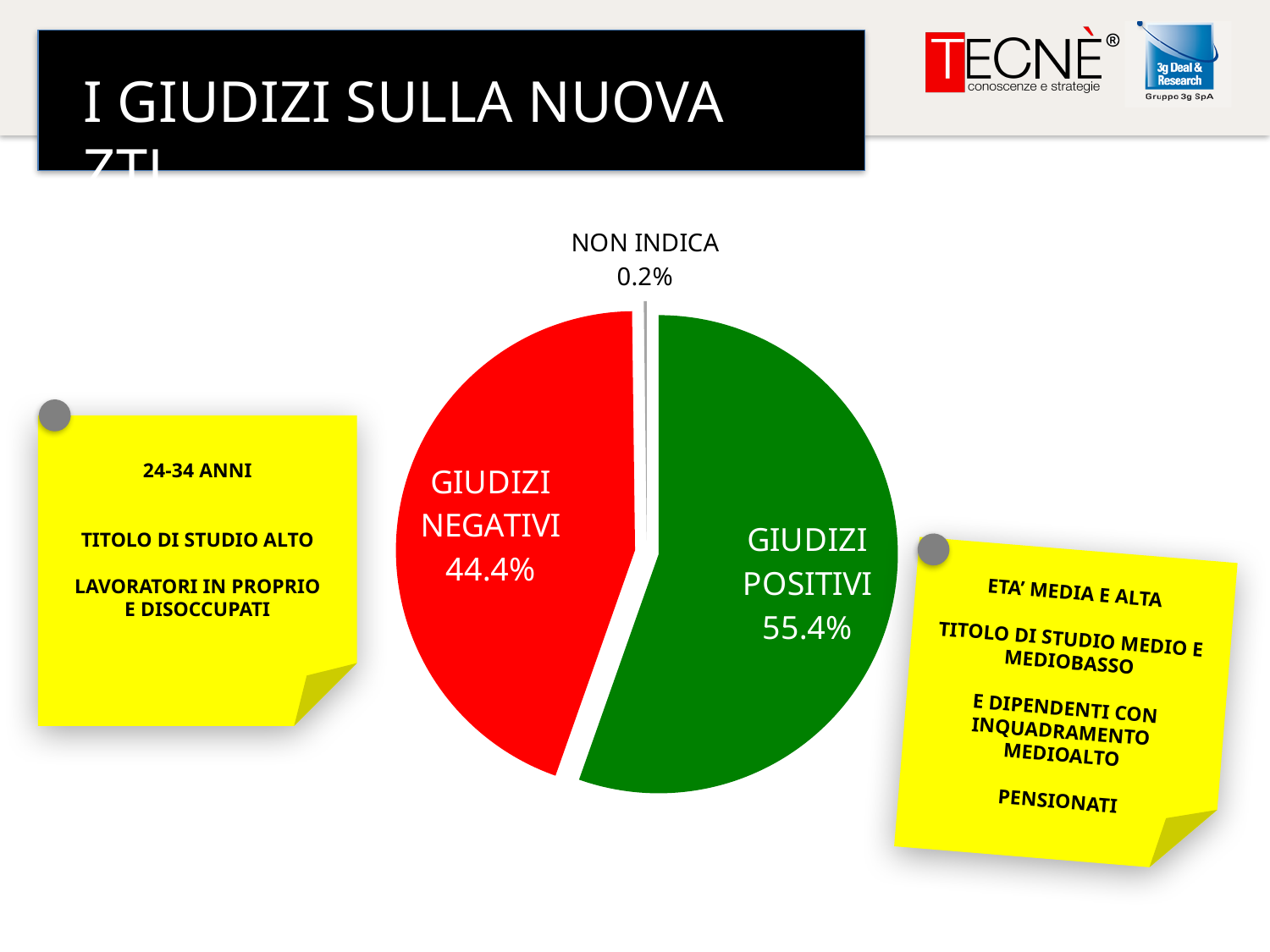
What colour is the GIUDIZI NEGATIVI slice? red What share of the pie is NON INDICA? 0.2% Which slice of the pie is the smallest? NON INDICA Which slice of the pie is the largest? GIUDIZI POSITIVI How many slices does the pie chart have? 3 What is the difference in percentage points between GIUDIZI POSITIVI and GIUDIZI NEGATIVI? 11 percentage points What kind of chart is shown on the slide? pie chart Which is larger, GIUDIZI NEGATIVI or GIUDIZI POSITIVI? GIUDIZI POSITIVI What share of the pie is GIUDIZI NEGATIVI? 44.4% Is the share for GIUDIZI NEGATIVI greater or less than 50%? less What colour is the GIUDIZI POSITIVI slice? green What share of the pie is GIUDIZI POSITIVI? 55.4%